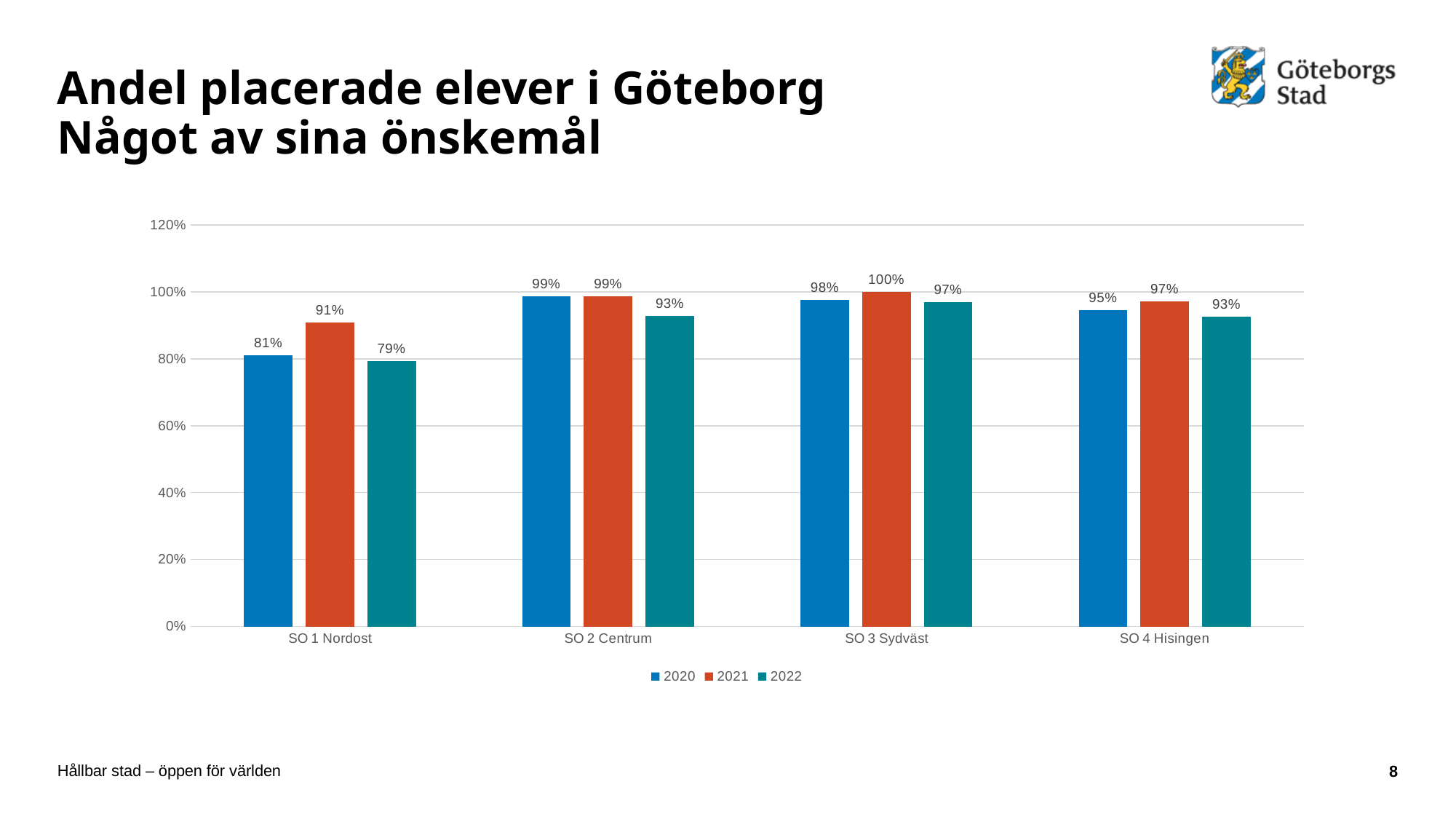
Which series is shown in orange in the legend? 2021 What is the value for SO 1 Nordost in 2020? 81% What is the value for SO 4 Hisingen in 2022? 93% What is the value for SO 2 Centrum in 2022? 93% What is the value for SO 3 Sydväst in 2021? 100% What kind of chart is shown on the slide? Bar chart Which is larger for SO 4 Hisingen: the 2020 value or the 2021 value? 2021 What is the difference between the 2021 and 2022 values for SO 1 Nordost? 12% Which category has the lowest value in the 2022 series? SO 1 Nordost Which category has the highest value in the 2021 series? SO 3 Sydväst How many series does the legend list? 3 How many categories are shown on the x axis? 4